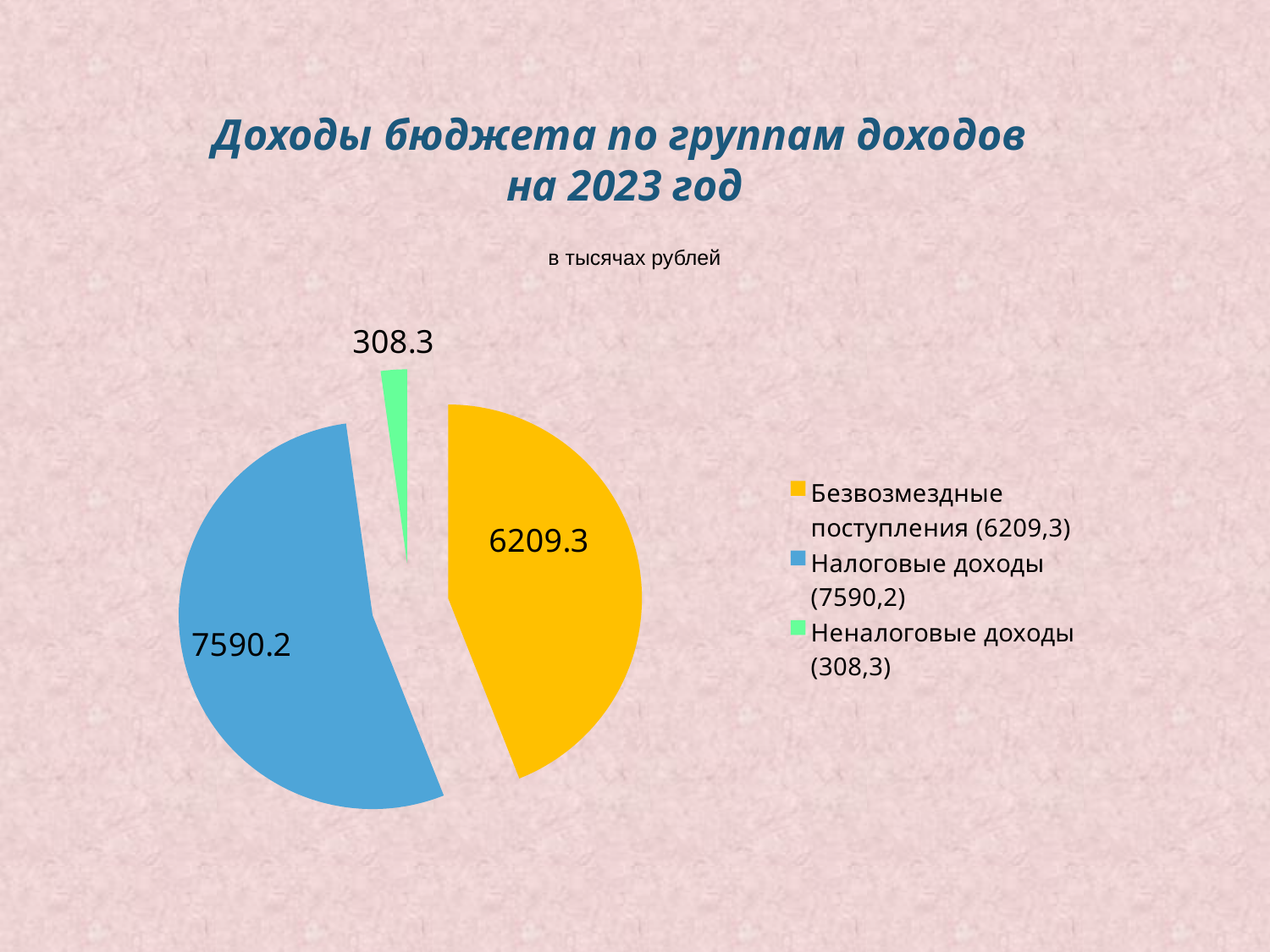
How many slices does the pie chart have? 3 Which is larger, Налоговые доходы or Безвозмездные поступления? Налоговые доходы What is the difference between Безвозмездные поступления and Неналоговые доходы? 5901.0 What unit is stated for the values on the slide? в тысячах рублей What type of chart is shown on the slide? pie chart Which income group has the smallest slice? Неналоговые доходы What is the difference between Налоговые доходы and Безвозмездные поступления? 1380.9 Which income group has the largest slice? Налоговые доходы What share of the pie does Налоговые доходы represent? 53.8% What is the value for Налоговые доходы? 7590.2 What is the value for Безвозмездные поступления? 6209.3 What is the value for Неналоговые доходы? 308.3